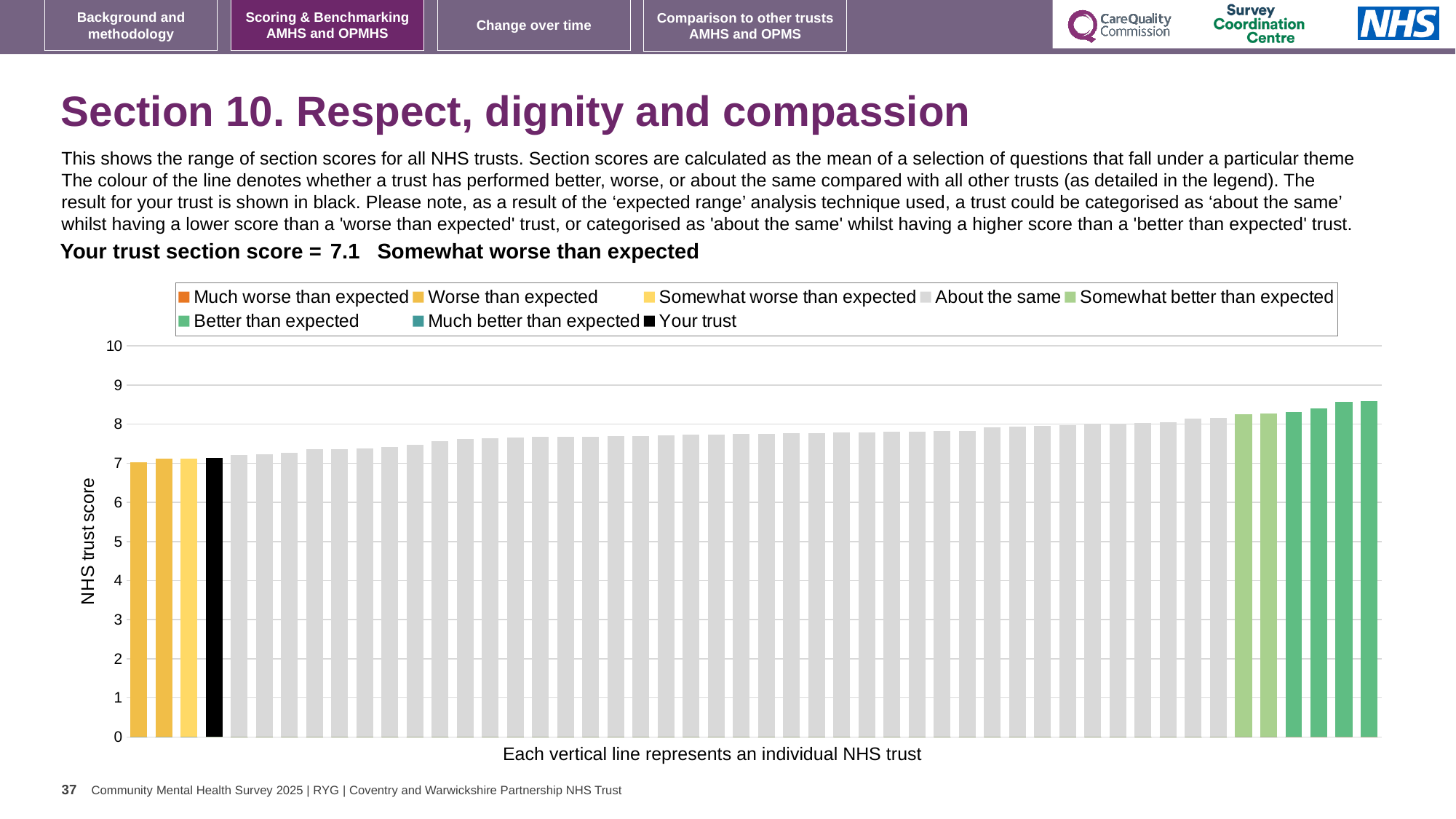
Is the value for the leftmost bar greater or less than 6? greater How many entries does the chart legend list? 8 How many bars are coloured black (Your trust)? 1 Is the value for the rightmost bar greater or less than 8? greater What is the label on the vertical axis of the chart? NHS trust score What is the section score for your trust shown on the slide? 7.1 Is the tallest bar on the left or the right side of the chart? right Which category is your trust's section score placed in, according to the text above the chart? Somewhat worse than expected Is the value for your trust (the black bar) greater or less than 8? less Do the bar values rise or fall from left to right along the x axis? rise Which is larger: the value for your trust (black bar) or the value for the rightmost bar? the rightmost bar What kind of chart is shown on the slide? bar chart